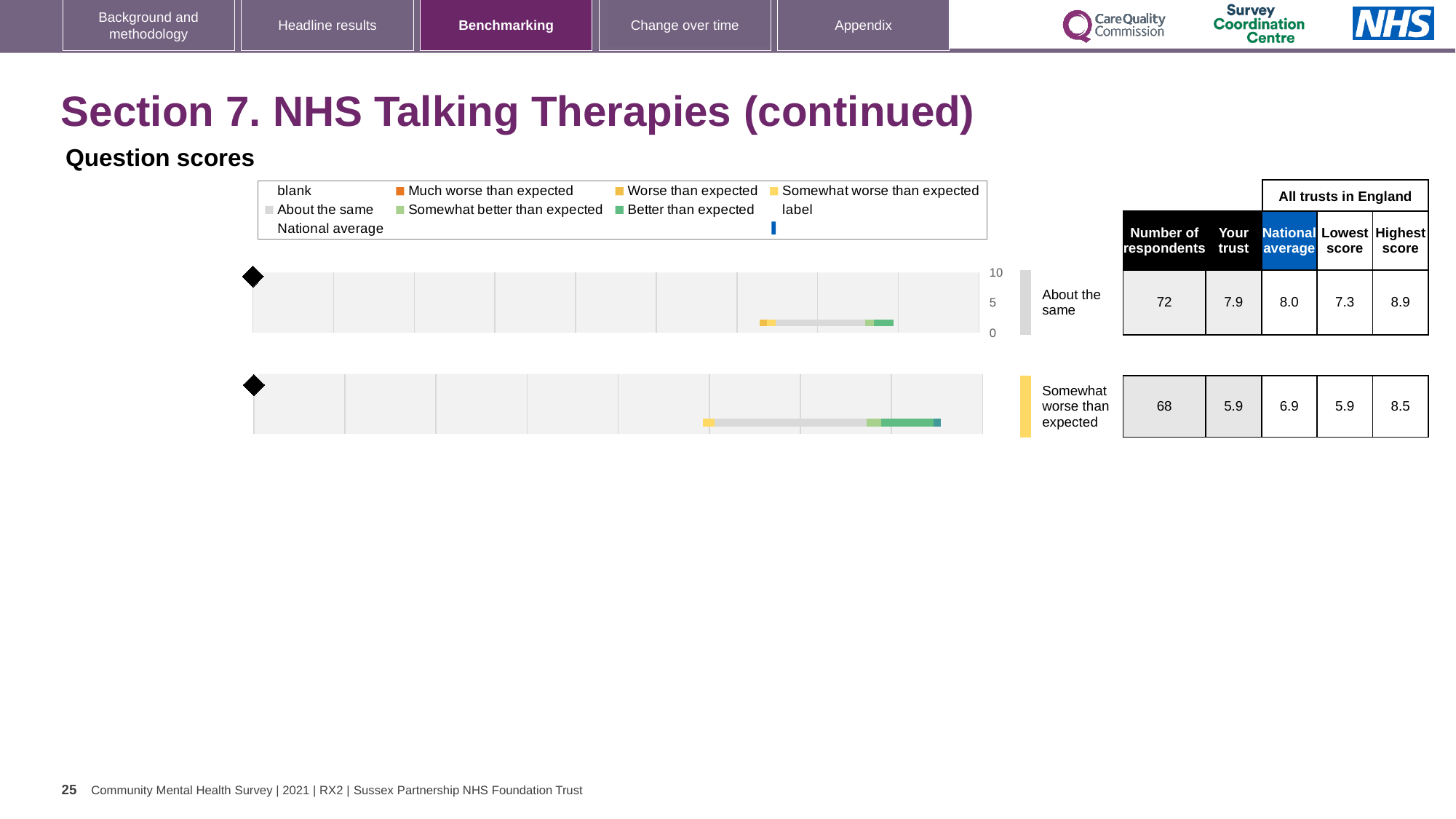
Which question has the higher 'Your trust' score: the one rated 'About the same' or the one rated 'Somewhat worse than expected'? About the same What kind of chart is used to show the question scores on this slide? Bar chart What is the highest score among all trusts in England for the question rated 'Somewhat worse than expected'? 8.5 Is the 'Your trust' score for the question rated 'About the same' greater or less than 5? greater What is the national average for the question rated 'Somewhat worse than expected'? 6.9 For the question rated 'About the same', what is the difference between the highest and lowest scores across all trusts in England? 1.6 What is the 'Your trust' score for the question rated 'About the same'? 7.9 How many respondents answered the question rated 'About the same'? 72 How many question score bars are shown on the slide? 2 For the question rated 'Somewhat worse than expected', what is the difference between the national average and the 'Your trust' score? 1.0 What is the lowest score among all trusts in England for the question rated 'About the same'? 7.3